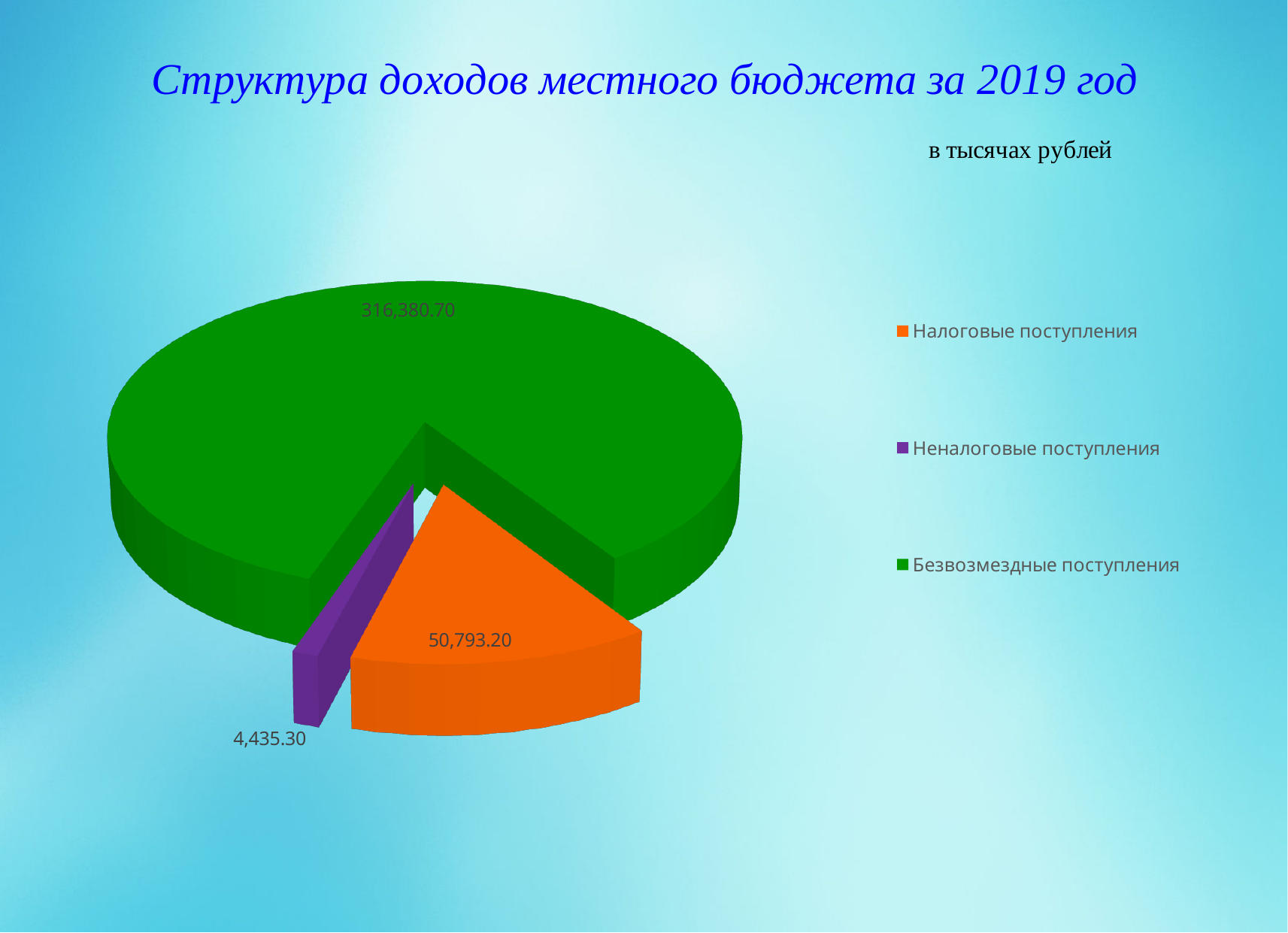
Which is larger, the value for Налоговые поступления or the value for Неналоговые поступления? Налоговые поступления What is the total of all three slices in the pie chart? 371,609.20 What is the value for Налоговые поступления? 50,793.20 What is the difference between the values for Налоговые поступления and Неналоговые поступления? 46,357.90 Which category has the largest slice of the pie? Безвозмездные поступления How many categories does the pie chart show? 3 Which category has the smallest slice of the pie? Неналоговые поступления What colour is the slice for Безвозмездные поступления? Green What type of chart is shown on the slide? Pie chart What is the value for Неналоговые поступления? 4,435.30 What is the value for Безвозмездные поступления? 316,380.70 What is the difference between the values for Безвозмездные поступления and Налоговые поступления? 265,587.50